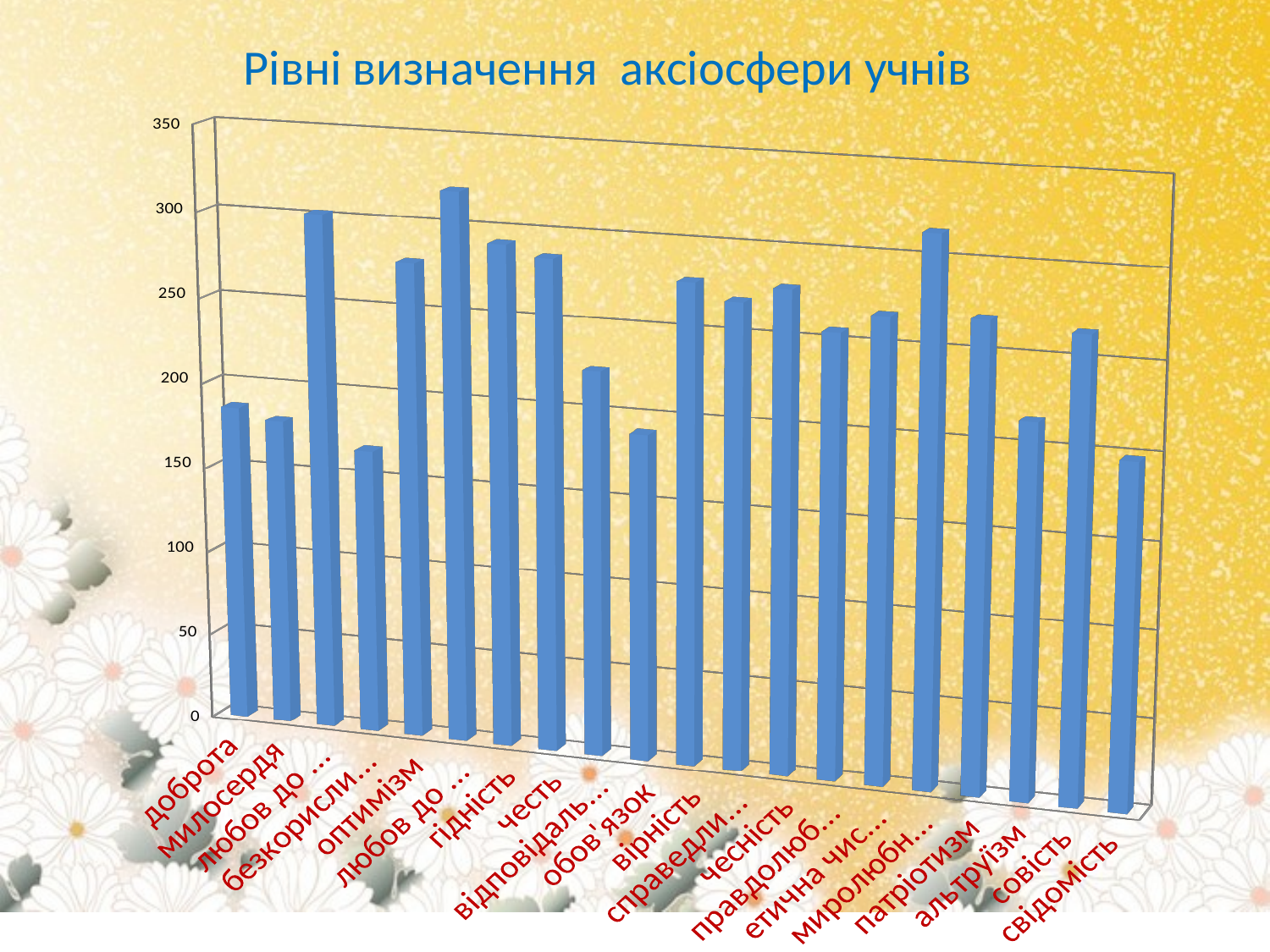
Which is larger, the value for честь or the value for совість? честь Is the value for обов'язок greater or less than 200? less Which is larger, the value for гідність or the value for обов'язок? гідність Is the value for оптимізм greater or less than 250? greater Is the value for свідомість greater or less than 200? less What kind of chart is shown on the slide? bar chart Which is larger, the value for миролюбн... or the value for альтруїзм? миролюбн... How many bars (categories) does the chart show? 20 What is the title of the chart? Рівні визначення аксіосфери учнів